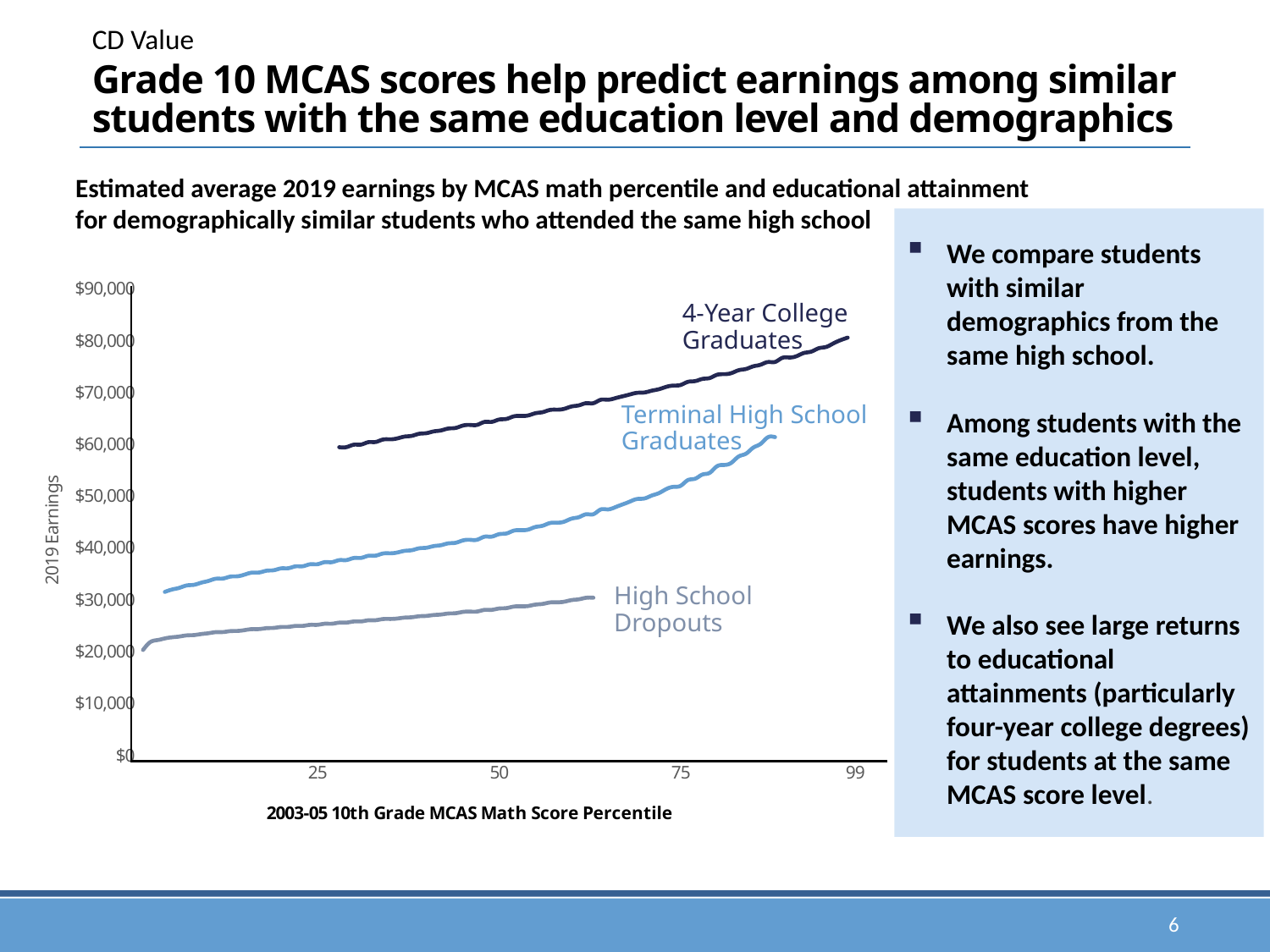
Is the value for 4-Year College Graduates at the 50th percentile greater or less than $60,000? greater Is the value for High School Dropouts at the 50th percentile greater or less than $30,000? less Is the value for Terminal High School Graduates at the 50th percentile greater or less than $50,000? less How many series (lines) are plotted on the chart? 3 Do earnings for High School Dropouts rise or fall as the MCAS math score percentile increases? rise Do earnings for Terminal High School Graduates rise or fall as the MCAS math score percentile increases? rise Which series has the lowest earnings across the chart? High School Dropouts What kind of chart is shown on the slide? line chart What is the label of the y axis? 2019 Earnings Which series has the highest earnings across the chart? 4-Year College Graduates At the 50th percentile, which series has higher earnings: 4-Year College Graduates or Terminal High School Graduates? 4-Year College Graduates What is the label of the x axis? 2003-05 10th Grade MCAS Math Score Percentile